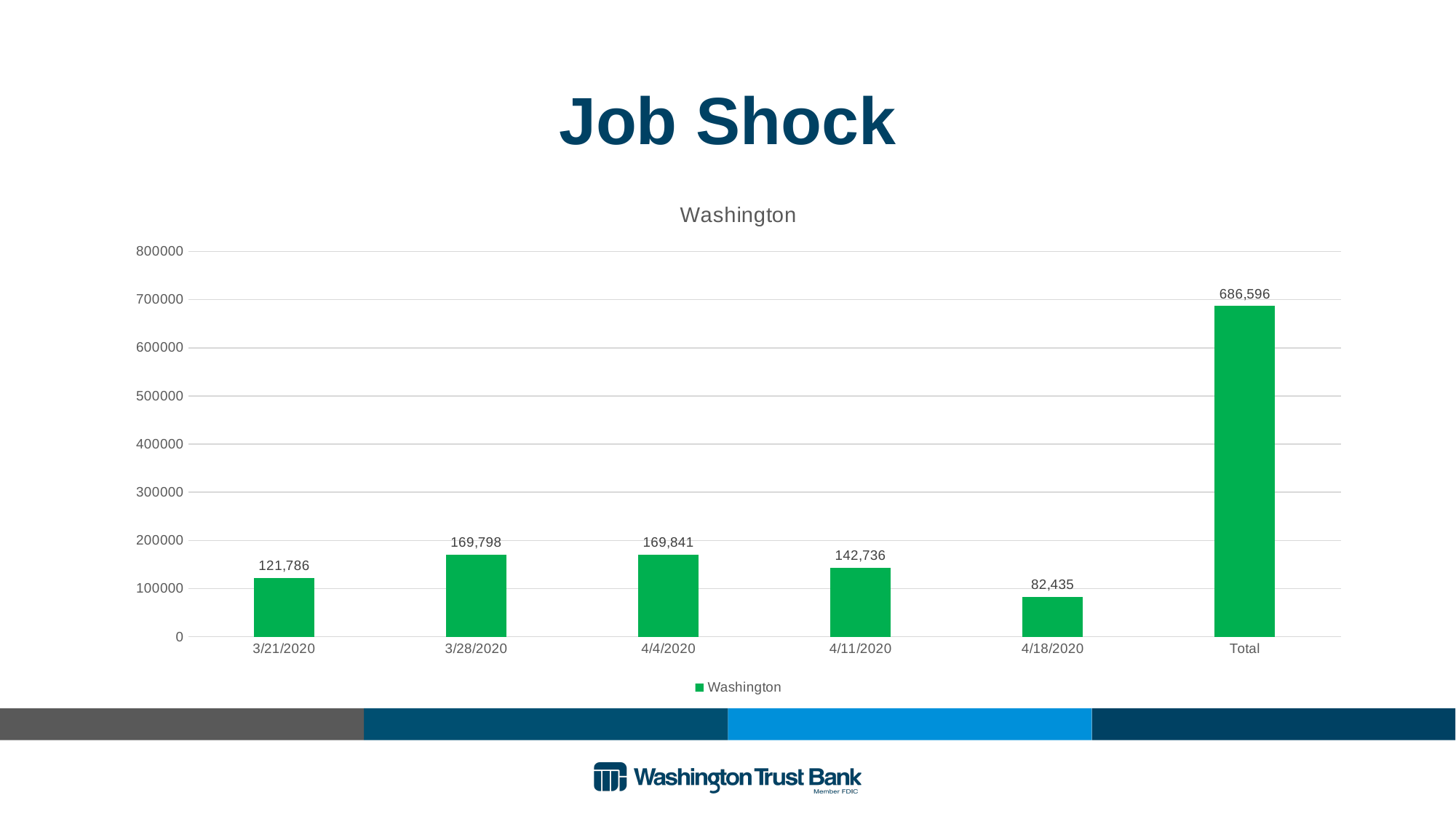
What kind of chart is shown on the slide? Bar chart What is the difference between the values for 4/11/2020 and 4/18/2020? 60,301 What series name does the legend show? Washington Which category has the lowest value? 4/18/2020 How many bars are shown in the chart? 6 What is the value for 4/11/2020? 142,736 What is the value for 4/18/2020? 82,435 What is the value for the Total bar? 686,596 What is the value for 3/21/2020? 121,786 Is the value for 3/28/2020 greater or less than 200000? less Which is larger, the value for 3/21/2020 or the value for 4/11/2020? 4/11/2020 Excluding the Total bar, which date has the highest value? 4/4/2020